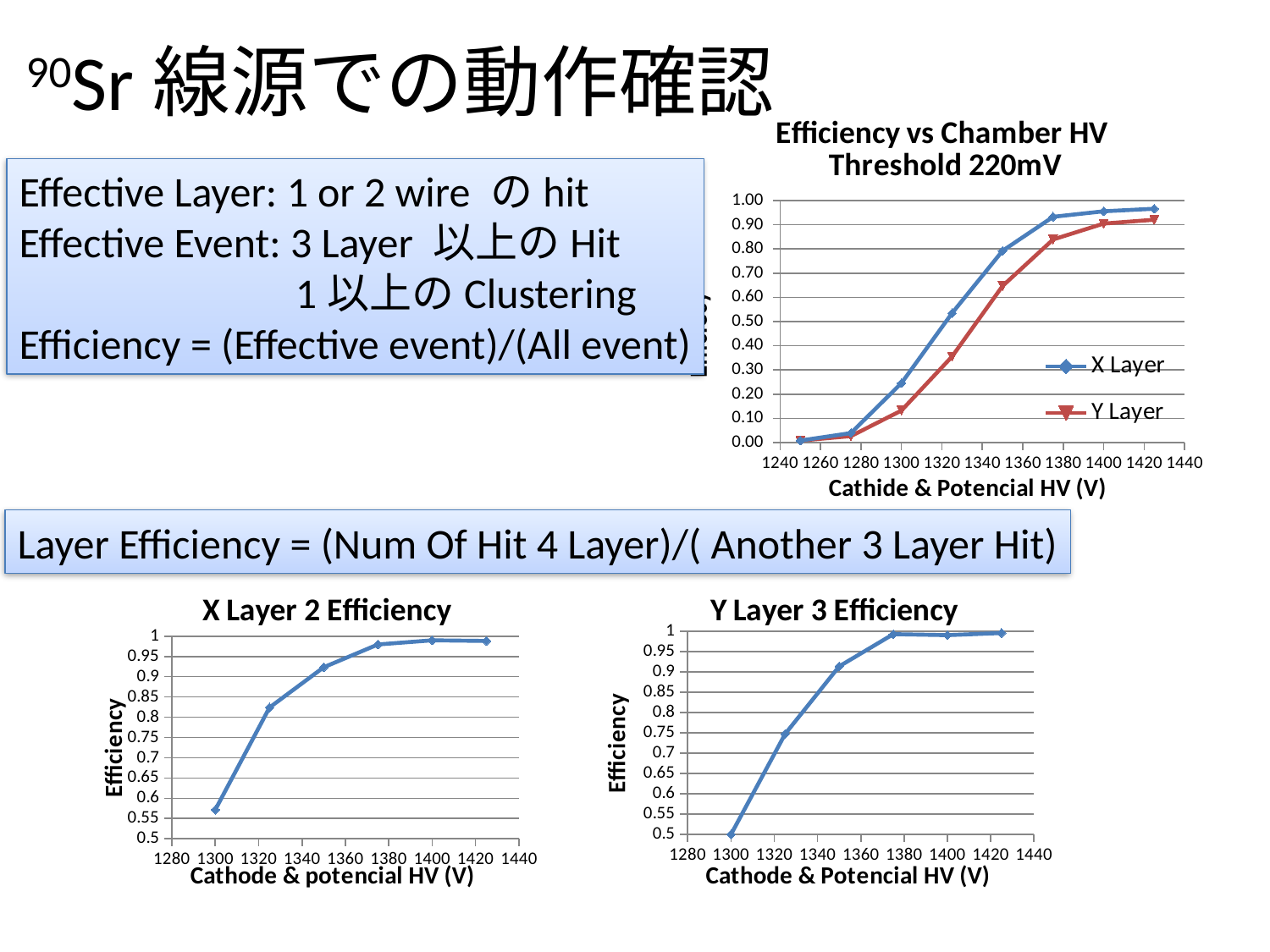
In the 'Efficiency vs Chamber HV Threshold 220mV' chart, what are the two legend entries? X Layer, Y Layer In the 'Efficiency vs Chamber HV Threshold 220mV' chart, how many series does the legend list? 2 In the 'X Layer 2 Efficiency' chart, how many data points are plotted? 6 In the 'Efficiency vs Chamber HV Threshold 220mV' chart, is the X Layer efficiency at 1300 V greater or less than 0.50? less In the 'Y Layer 3 Efficiency' chart, is the efficiency at 1325 V greater or less than 0.8? less In the 'Efficiency vs Chamber HV Threshold 220mV' chart, what is the x-axis title? Cathide & Potencial HV (V) In the 'Efficiency vs Chamber HV Threshold 220mV' chart, does the X Layer efficiency rise or fall as the HV increases? Rise In the 'X Layer 2 Efficiency' chart, is the efficiency at 1300 V greater or less than 0.7? less In the 'Y Layer 3 Efficiency' chart, does the efficiency rise or fall as the HV increases from 1300 V to 1375 V? Rise In the 'Efficiency vs Chamber HV Threshold 220mV' chart, what kind of chart is shown? Line chart In the 'Efficiency vs Chamber HV Threshold 220mV' chart, at 1350 V, which series has the higher efficiency, X Layer or Y Layer? X Layer